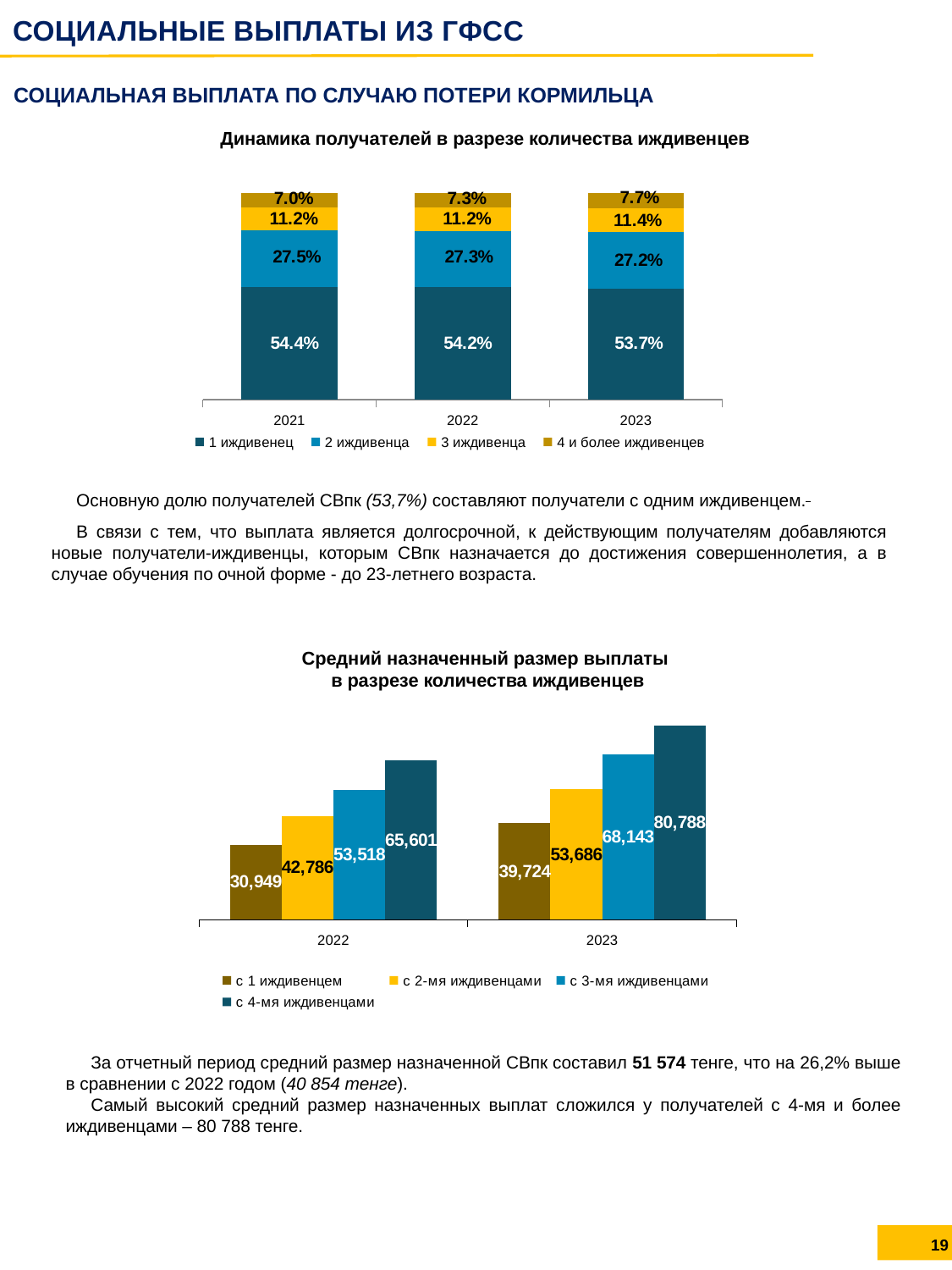
In the chart 'Средний назначенный размер выплаты в разрезе количества иждивенцев', what is the difference between the 'с 4-мя иждивенцами' values in 2023 and 2022? 15,187 In the chart 'Средний назначенный размер выплаты в разрезе количества иждивенцев', which is larger: 'с 2-мя иждивенцами' in 2023 or 'с 3-мя иждивенцами' in 2022? с 2-мя иждивенцами in 2023 In the chart 'Динамика получателей в разрезе количества иждивенцев', how many series does the legend list? 4 In the chart 'Динамика получателей в разрезе количества иждивенцев', what is the share of '1 иждивенец' in 2023? 53.7% In the chart 'Средний назначенный размер выплаты в разрезе количества иждивенцев', which series has the lowest value in 2022? с 1 иждивенцем In the chart 'Средний назначенный размер выплаты в разрезе количества иждивенцев', which series has the highest value in 2023? с 4-мя иждивенцами In the chart 'Средний назначенный размер выплаты в разрезе количества иждивенцев', what is the value for 'с 3-мя иждивенцами' in 2023? 68,143 In the chart 'Динамика получателей в разрезе количества иждивенцев', does the share of '4 и более иждивенцев' rise or fall from 2021 to 2023? rise In the chart 'Динамика получателей в разрезе количества иждивенцев', what is the value for '4 и более иждивенцев' in 2021? 7.0% In the chart 'Динамика получателей в разрезе количества иждивенцев', what is the difference between the '2 иждивенца' share in 2021 and in 2023? 0.3% What kind of chart is 'Средний назначенный размер выплаты в разрезе количества иждивенцев'? bar chart In the chart 'Динамика получателей в разрезе количества иждивенцев', how many years are shown on the x axis? 3